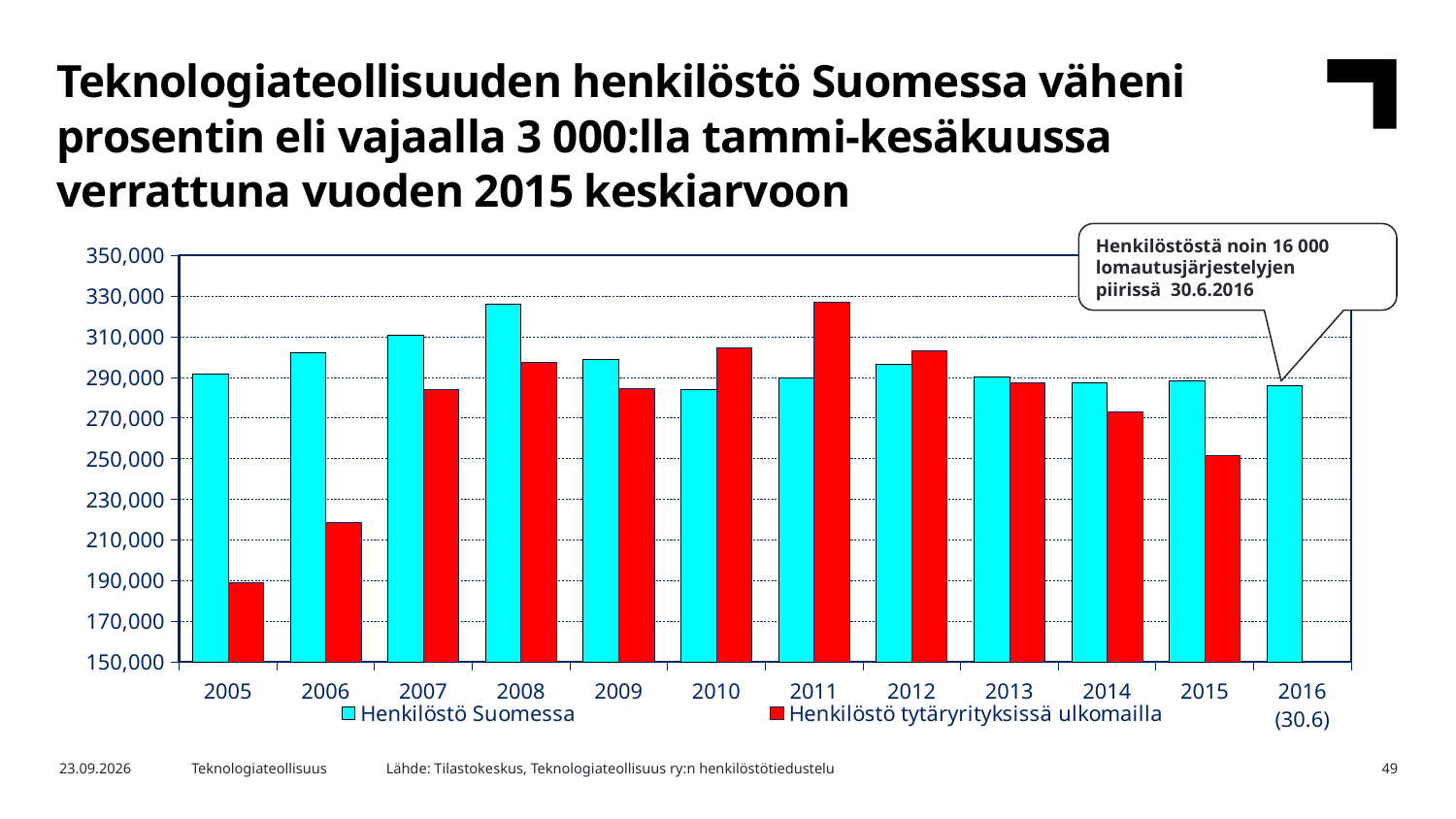
In which year is Henkilöstö tytäryrityksissä ulkomailla lowest? 2005 How many series does the legend list? 2 In 2015, which is larger: Henkilöstö Suomessa or Henkilöstö tytäryrityksissä ulkomailla? Henkilöstö Suomessa In which year is Henkilöstö Suomessa highest? 2008 Is the value for Henkilöstö tytäryrityksissä ulkomailla in 2014 greater or less than 290,000? less In 2011, which is larger: Henkilöstö Suomessa or Henkilöstö tytäryrityksissä ulkomailla? Henkilöstö tytäryrityksissä ulkomailla Is the value for Henkilöstö tytäryrityksissä ulkomailla in 2005 greater or less than 210,000? less How many years are shown on the x axis? 12 What kind of chart is shown on the slide? Bar chart Is the value for Henkilöstö Suomessa in 2008 greater or less than 310,000? greater In which year is Henkilöstö tytäryrityksissä ulkomailla highest? 2011 Does Henkilöstö tytäryrityksissä ulkomailla rise or fall from 2011 to 2015? Fall